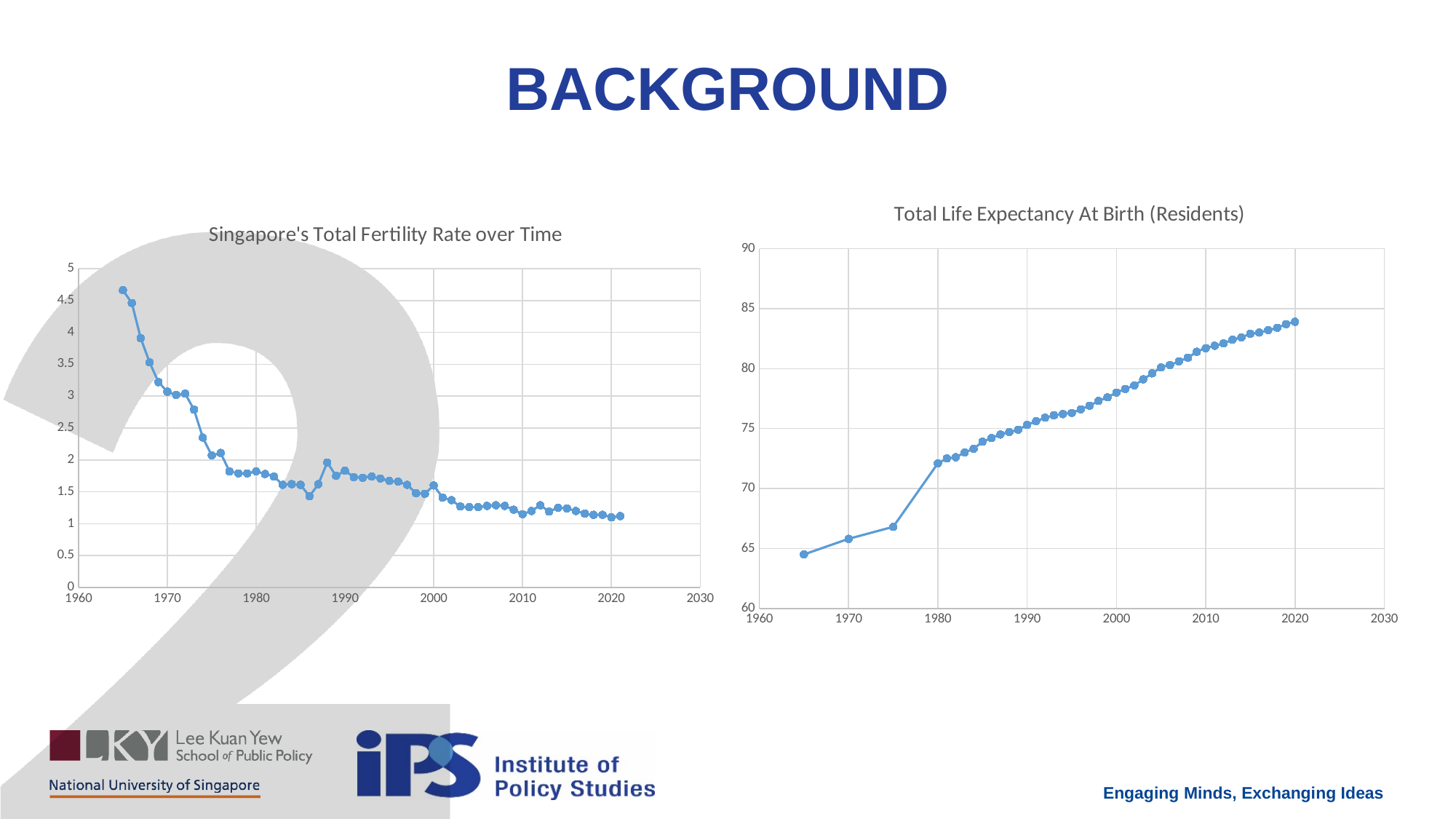
What is the title of the chart on the right side of the slide? Total Life Expectancy At Birth (Residents) In "Singapore's Total Fertility Rate over Time", is the value for 2020 greater or less than 1.5? less In "Total Life Expectancy At Birth (Residents)", is the value for 2000 greater or less than 80? less In "Singapore's Total Fertility Rate over Time", is the value for 1975 greater or less than 3? less In "Singapore's Total Fertility Rate over Time", do the values generally rise or fall from 1965 to 2020? Fall What kind of chart is "Total Life Expectancy At Birth (Residents)"? Line chart What is the highest value shown on the y axis of "Singapore's Total Fertility Rate over Time"? 5 In "Total Life Expectancy At Birth (Residents)", do the values rise or fall from 1965 to 2020? Rise What kind of chart is "Singapore's Total Fertility Rate over Time"? Line chart